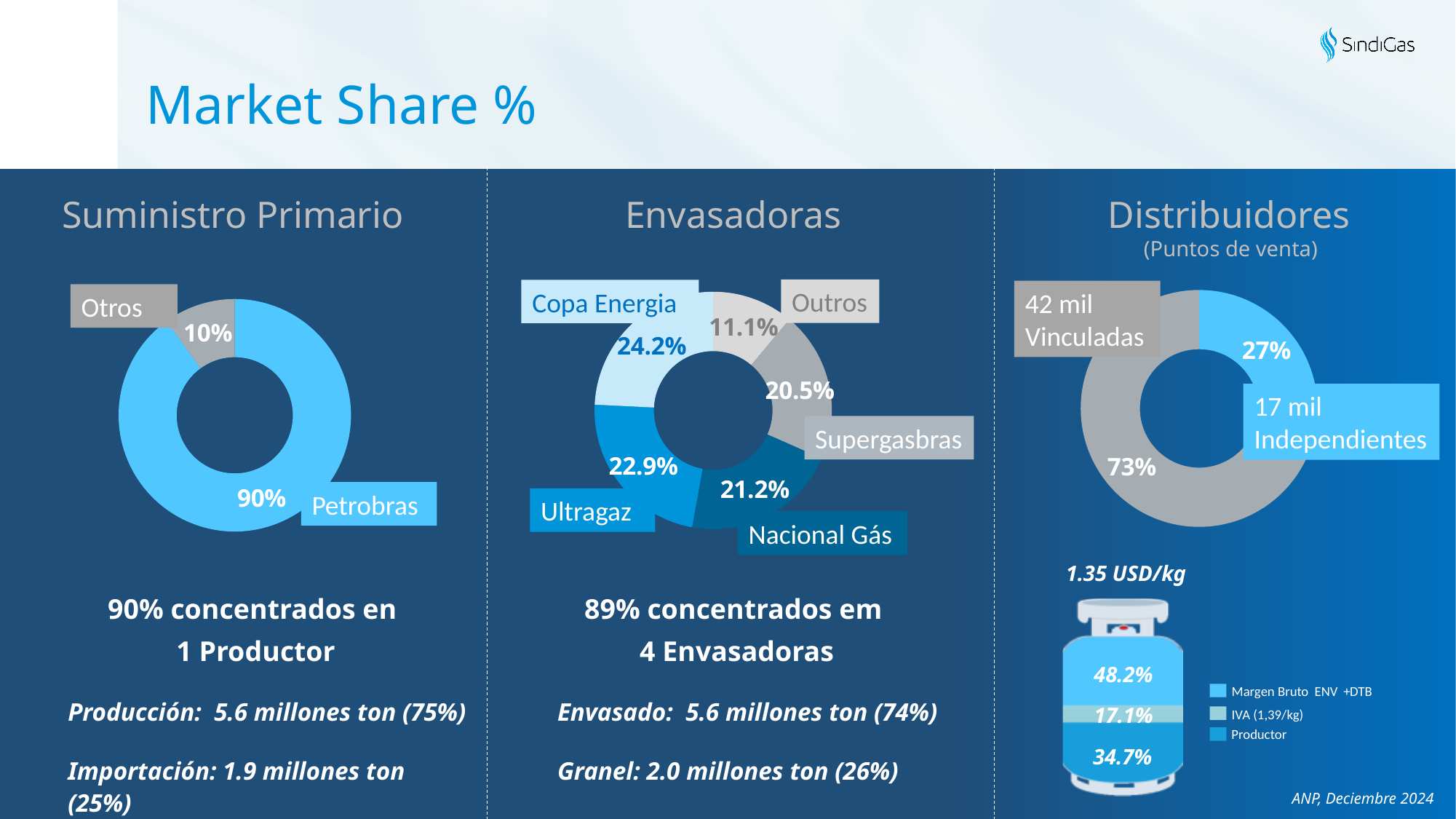
How many slices does the Suministro Primario chart have? 2 In the Suministro Primario chart, what share of the pie does Otros take? 10% In the Envasadoras chart, which company has the largest share? Copa Energia In the Distribuidores chart, what share do the Vinculadas points of sale hold? 73% In the Envasadoras chart, what is the difference between Copa Energia and Ultragaz? 1.3 percentage points In the Distribuidores chart, what is the difference between the Vinculadas and Independientes shares? 46 percentage points In the Envasadoras chart, what is the value for Ultragaz? 22.9% How many slices does the Envasadoras chart have? 5 In the Envasadoras chart, which is larger, Nacional Gás or Supergasbras? Nacional Gás In the Suministro Primario chart, what share does Petrobras hold? 90% In the Envasadoras chart, which slice is the smallest? Outros What kind of chart is used in the Distribuidores section? Donut (pie) chart